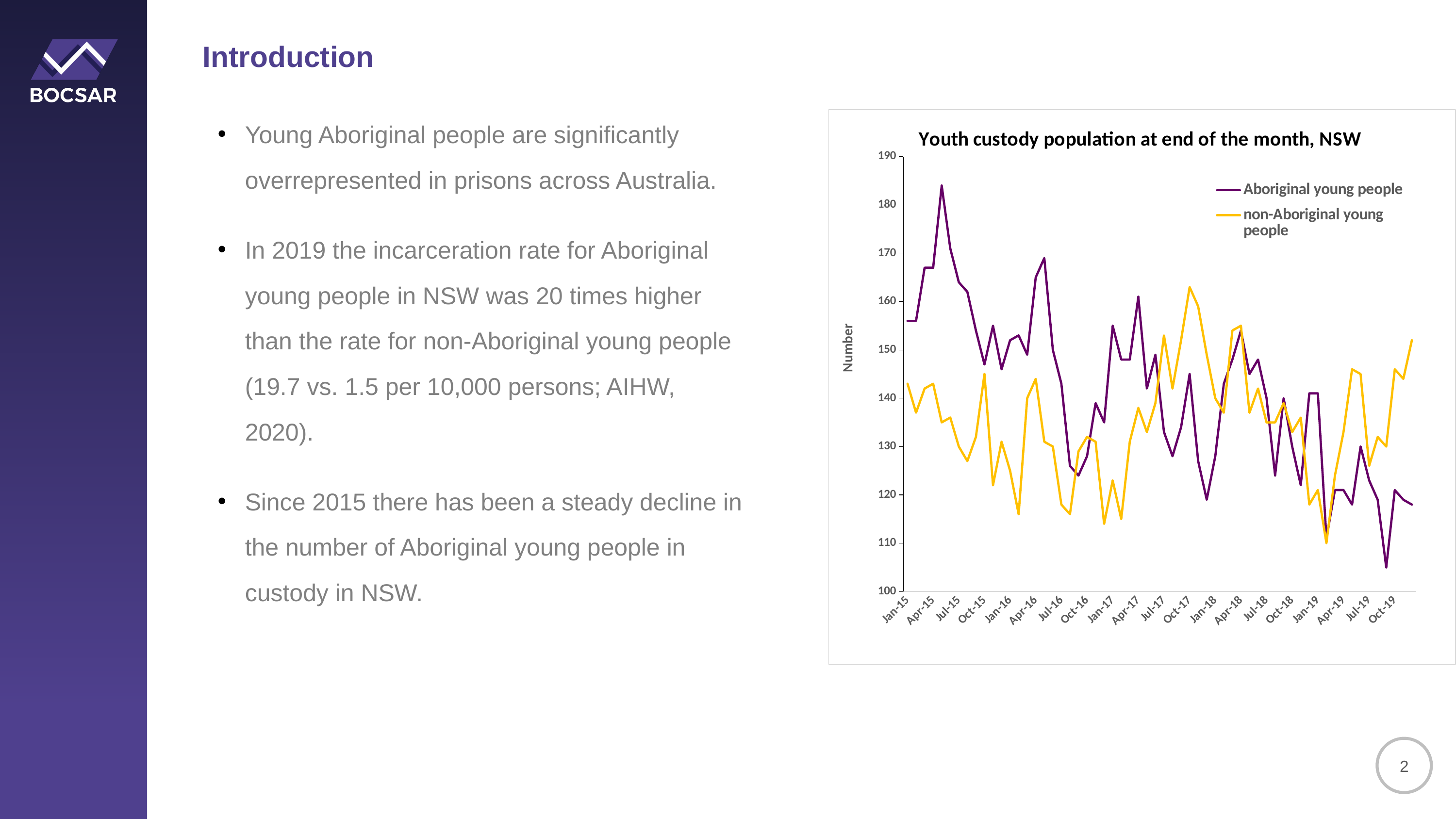
Is the value for non-Aboriginal young people at Jan-15 greater or less than 150? less Is the value for Aboriginal young people at Jan-15 greater or less than 150? greater Which series reaches the highest value anywhere on the chart? Aboriginal young people What is the label on the vertical axis of the chart? Number At Oct-19, which series has the larger value: Aboriginal young people or non-Aboriginal young people? non-Aboriginal young people Is the value for Aboriginal young people at Oct-19 greater or less than 130? less What is the title of the chart? Youth custody population at end of the month, NSW What kind of chart is shown on the slide? line chart How many series does the legend of the chart list? 2 Does the number of Aboriginal young people in custody rise or fall overall from Jan-15 to Oct-19? fall At Jan-15, which series has the larger value: Aboriginal young people or non-Aboriginal young people? Aboriginal young people